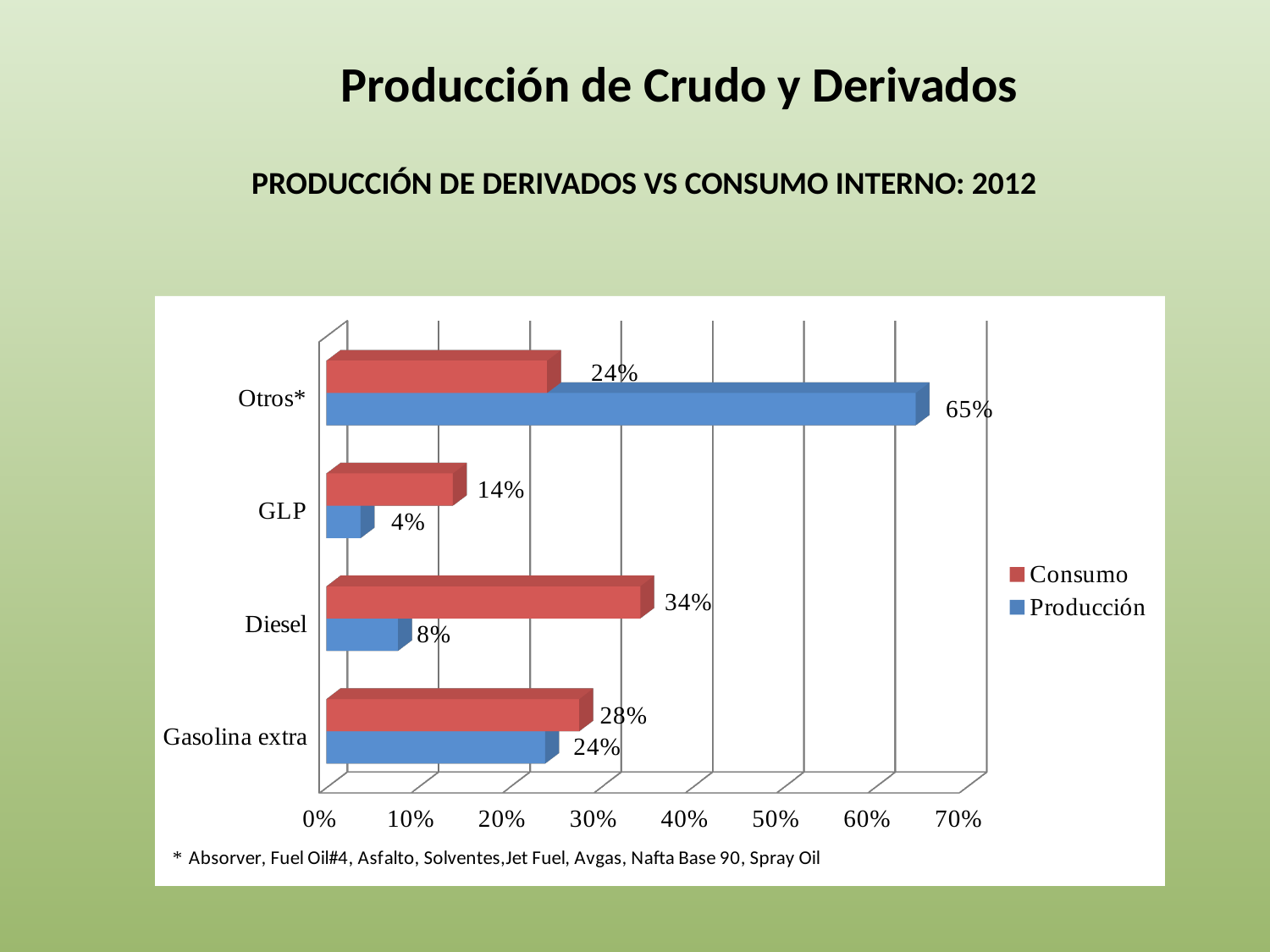
How many categories are shown on the chart? 4 What is the difference between Consumo and Producción for Diesel? 26% What is the Consumo value for Diesel? 34% Which is larger for Gasolina extra, Consumo or Producción? Consumo Which category has the highest Producción value? Otros* What is the difference between Producción and Consumo for Otros*? 41% Which category has the lowest Consumo value? GLP What kind of chart is shown on the slide? Bar chart How many series does the legend list? 2 What is the Consumo value for Gasolina extra? 28% What is the Producción value for GLP? 4% What is the Producción value for Otros*? 65%